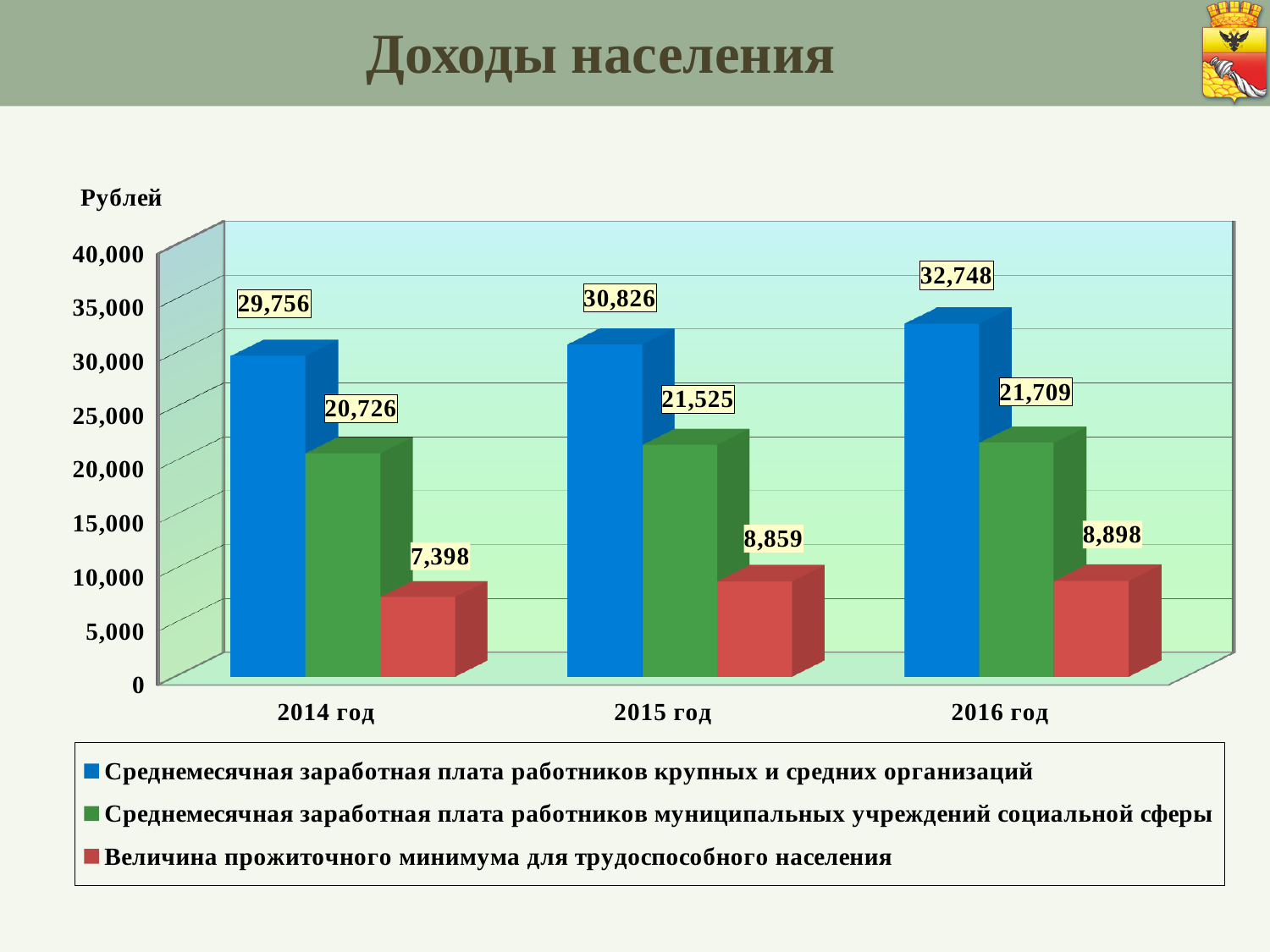
What is the value of Величина прожиточного минимума для трудоспособного населения in 2014 год? 7,398 How many series does the legend list? 3 What is the difference between the 2016 год and 2014 год values for Среднемесячная заработная плата работников крупных и средних организаций? 2,992 What is the average monthly salary of employees of municipal social-sphere institutions (Среднемесячная заработная плата работников муниципальных учреждений социальной сферы) in 2015 год? 21,525 Which is larger: the 2015 год value for Среднемесячная заработная плата работников муниципальных учреждений социальной сферы or the 2015 год value for Величина прожиточного минимума для трудоспособного населения? Среднемесячная заработная плата работников муниципальных учреждений социальной сферы What kind of chart is shown on the slide? bar chart In which year is the value for Среднемесячная заработная плата работников крупных и средних организаций the highest? 2016 год Is the 2014 год value for Среднемесячная заработная плата работников крупных и средних организаций greater or less than 25,000? greater How many years are shown on the x axis of the chart? 3 In which year is the value for Величина прожиточного минимума для трудоспособного населения the lowest? 2014 год Do the values for Величина прожиточного минимума для трудоспособного населения rise or fall from 2014 год to 2016 год? rise What is the average monthly salary of employees of large and medium organisations (Среднемесячная заработная плата работников крупных и средних организаций) in 2016 год? 32,748